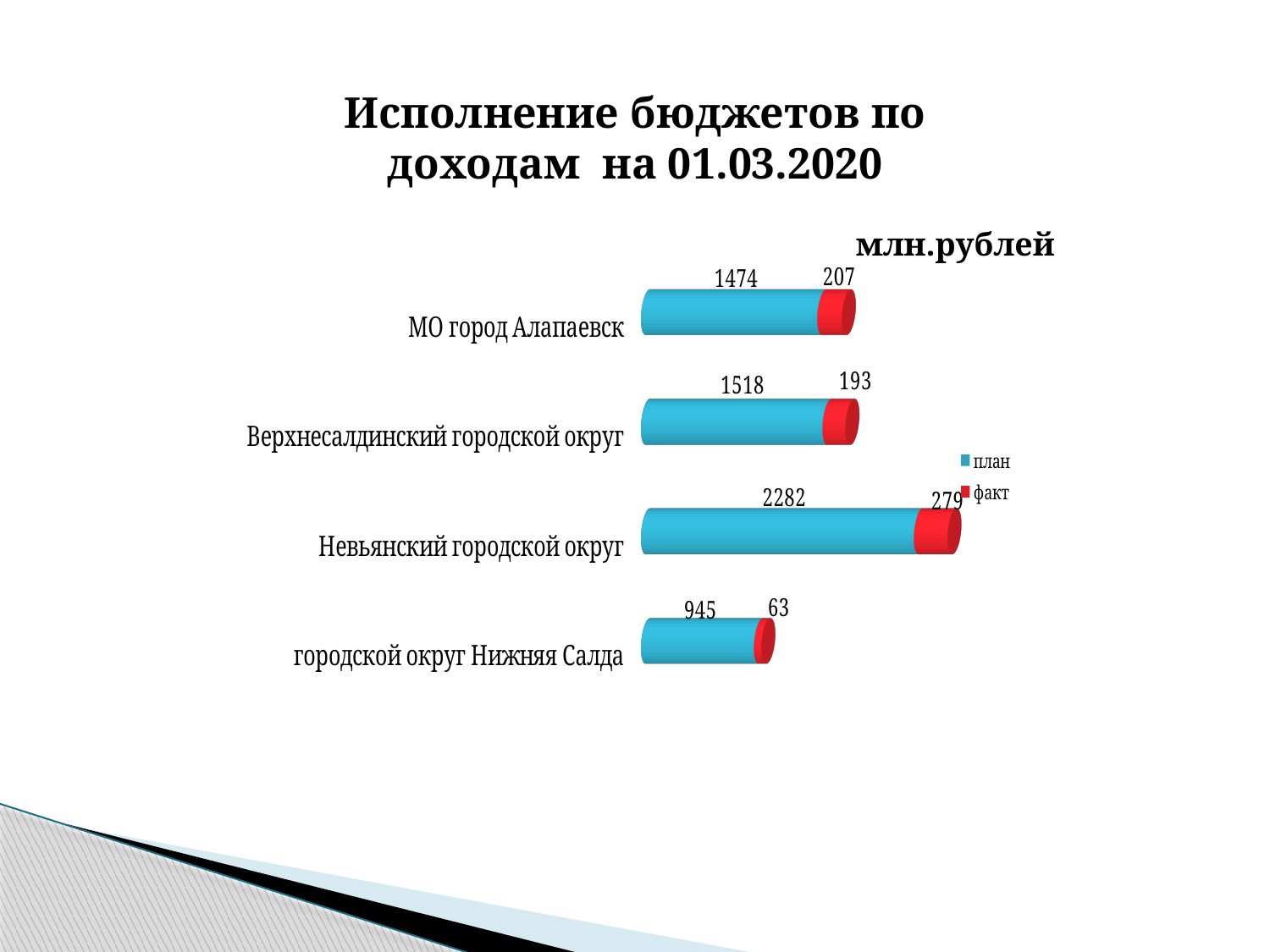
What is the difference between the план values for Верхнесалдинский городской округ and МО город Алапаевск? 44 How many categories are shown in the chart? 4 What is the факт value for МО город Алапаевск? 207 What is the план value for Невьянский городской округ? 2282 What is the difference between the план and факт values for Невьянский городской округ? 2003 What is the план value for городской округ Нижняя Салда? 945 How many series does the legend list? 2 Which is larger, the факт value for МО город Алапаевск or for Верхнесалдинский городской округ? МО город Алапаевск Which category has the lowest факт value? городской округ Нижняя Салда Which category has the highest план value? Невьянский городской округ What type of chart is shown on the slide? bar chart What is the факт value for Верхнесалдинский городской округ? 193